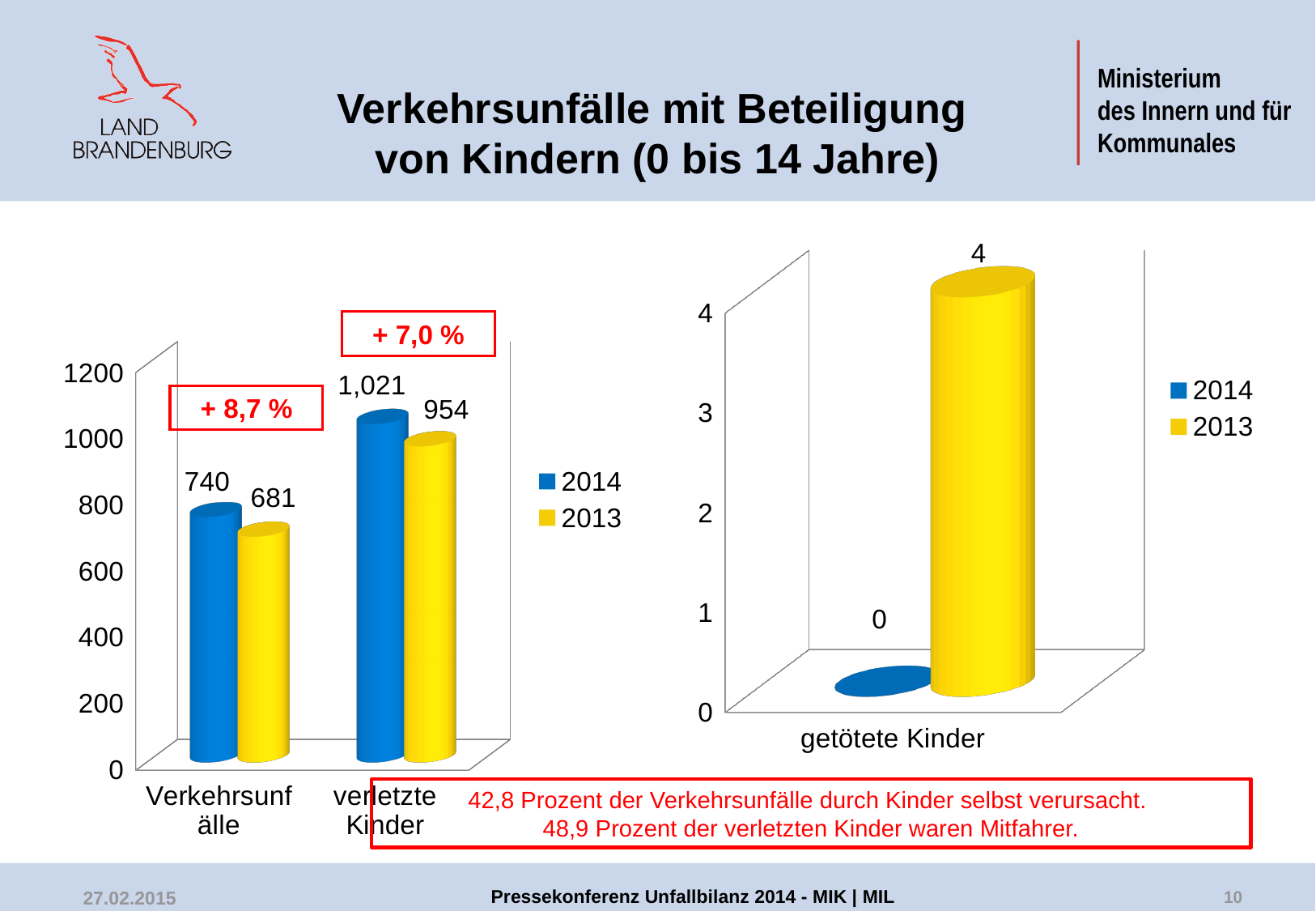
In the right chart, what is the value for getötete Kinder in 2013? 4 In the left chart, what is the value for verletzte Kinder in 2014? 1,021 In the left chart, what is the difference between the 2014 and 2013 values for verletzte Kinder? 67 In the left chart, what is the value for Verkehrsunfälle in 2014? 740 In the left chart, what is the difference between the 2014 and 2013 values for Verkehrsunfälle? 59 In the left chart, which colour represents the 2013 series? Yellow In the right chart, what is the value for getötete Kinder in 2014? 0 In the left chart, what is the value for Verkehrsunfälle in 2013? 681 In the left chart, how many series does the legend list? 2 In the left chart, which year has the larger value for verletzte Kinder, 2014 or 2013? 2014 What kind of chart is the right chart? Bar chart In the left chart, what is the value for verletzte Kinder in 2013? 954